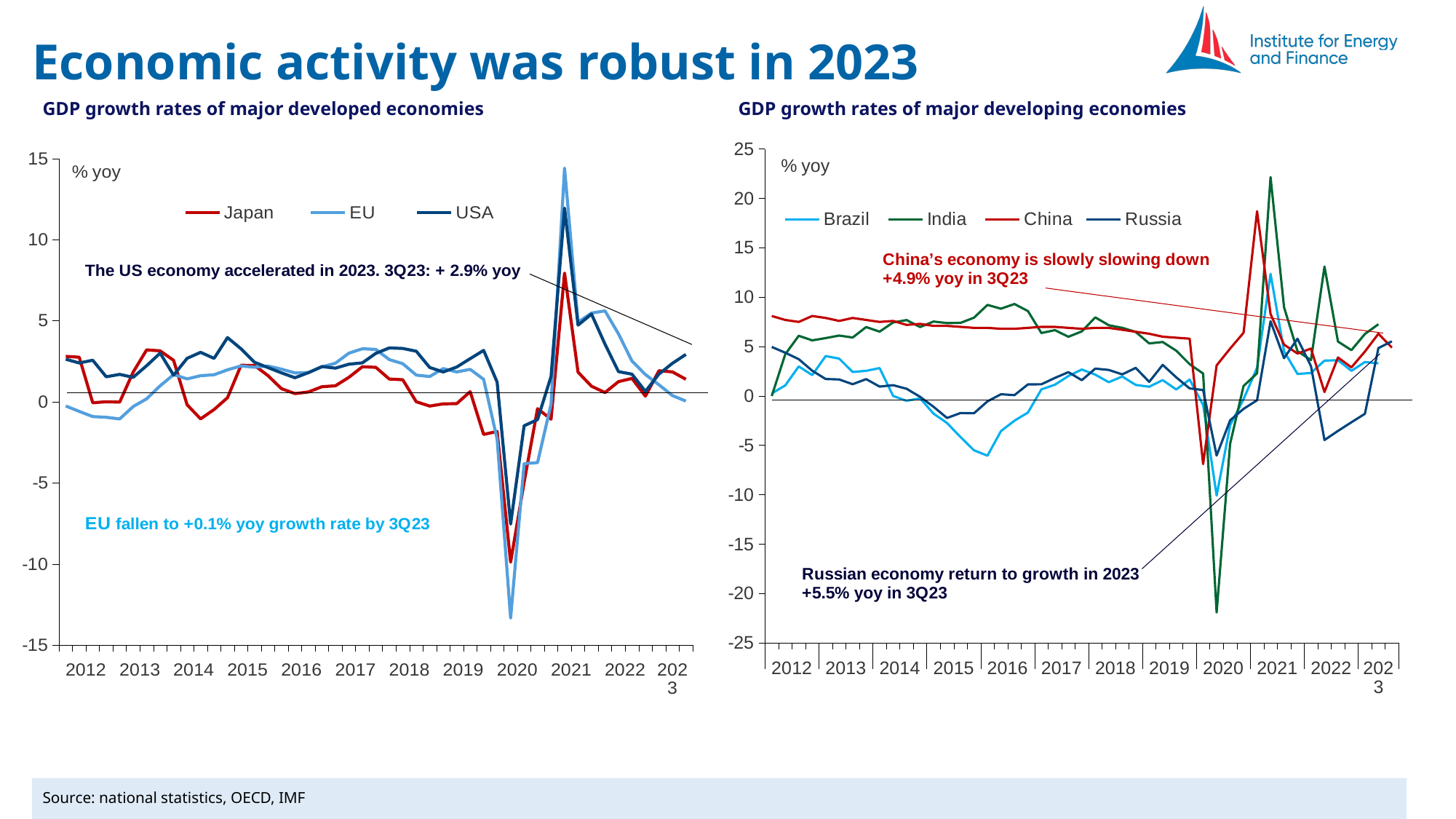
In the 'GDP growth rates of major developing economies' chart, is India's peak value in 2021 greater or less than 20? greater In the 'GDP growth rates of major developing economies' chart, by how many percentage points did Russia's 3Q23 growth exceed China's? 0.6 In the 'GDP growth rates of major developing economies' chart, which series fell to the lowest value in 2020? India In the 'GDP growth rates of major developed economies' chart, what was the EU growth rate by 3Q23? +0.1% yoy How many series does the legend of the 'GDP growth rates of major developed economies' chart list? 3 What type of chart is used for 'GDP growth rates of major developed economies'? Line chart In the 'GDP growth rates of major developed economies' chart, which series reached the highest peak in 2021? EU In the 'GDP growth rates of major developing economies' chart, what was Russia's GDP growth in 3Q23? +5.5% yoy In the 'GDP growth rates of major developed economies' chart, what was the US GDP growth rate in 3Q23? +2.9% yoy How many series does the legend of the 'GDP growth rates of major developing economies' chart list? 4 In the 'GDP growth rates of major developing economies' chart, what was China's GDP growth in 3Q23? +4.9% yoy In the 'GDP growth rates of major developing economies' chart, which had the higher growth rate in 3Q23, China or Russia? Russia